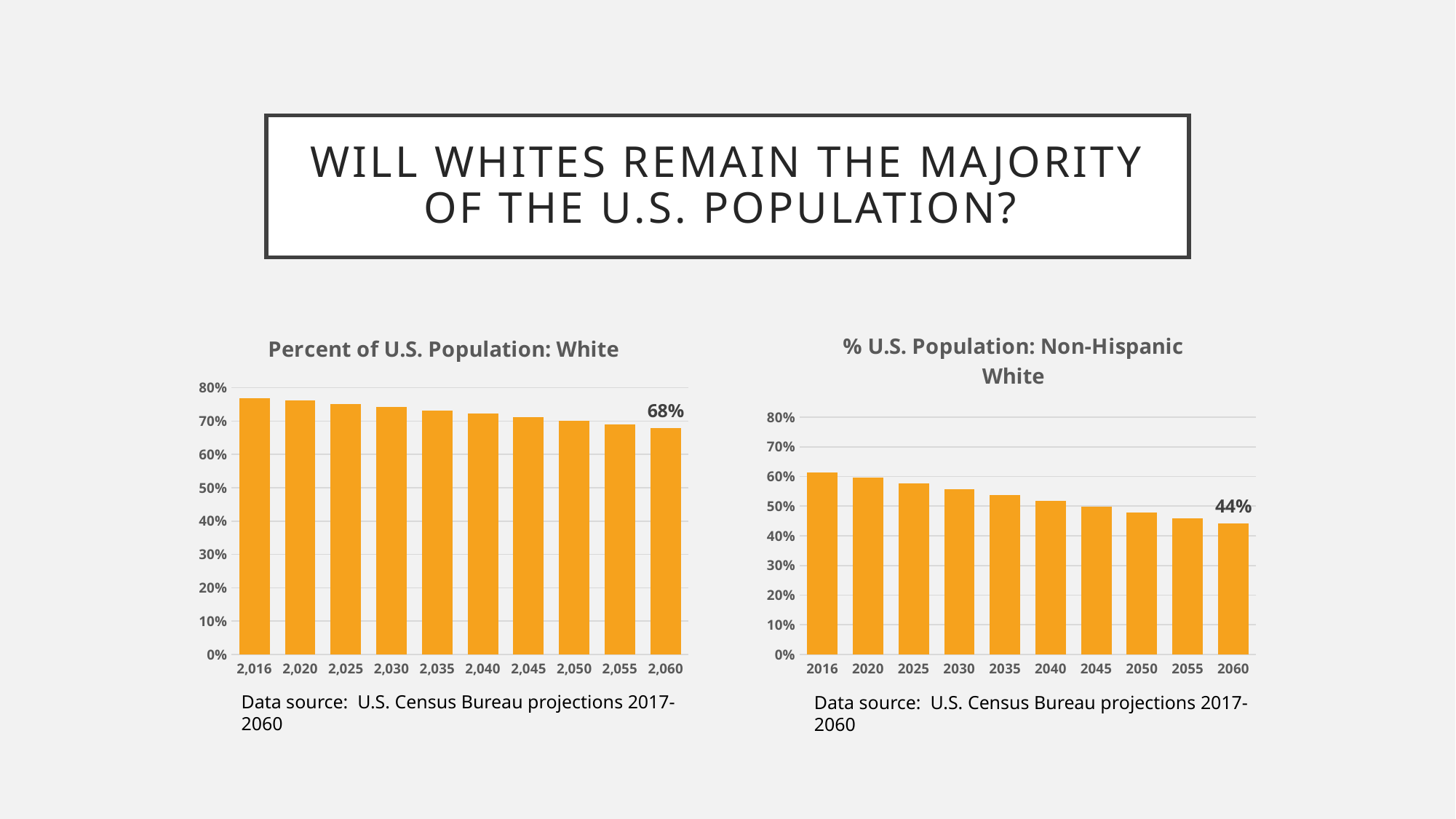
What is the title of the chart on the right side of the slide? % U.S. Population: Non-Hispanic White In the 'Percent of U.S. Population: White' chart, is the value for 2,016 greater or less than 70%? greater In the '% U.S. Population: Non-Hispanic White' chart, which year has the lowest value? 2060 In the '% U.S. Population: Non-Hispanic White' chart, what is the value for 2060? 44% How many years are shown on the x axis of the '% U.S. Population: Non-Hispanic White' chart? 10 In the 'Percent of U.S. Population: White' chart, what is the value for 2,060? 68% What kind of chart is the 'Percent of U.S. Population: White' chart? Bar chart In the '% U.S. Population: Non-Hispanic White' chart, do the values rise or fall from 2016 to 2060? Fall In the 'Percent of U.S. Population: White' chart, which year has the highest value? 2,016 In the 'Percent of U.S. Population: White' chart, which is larger, the value for 2,020 or the value for 2,050? 2,020